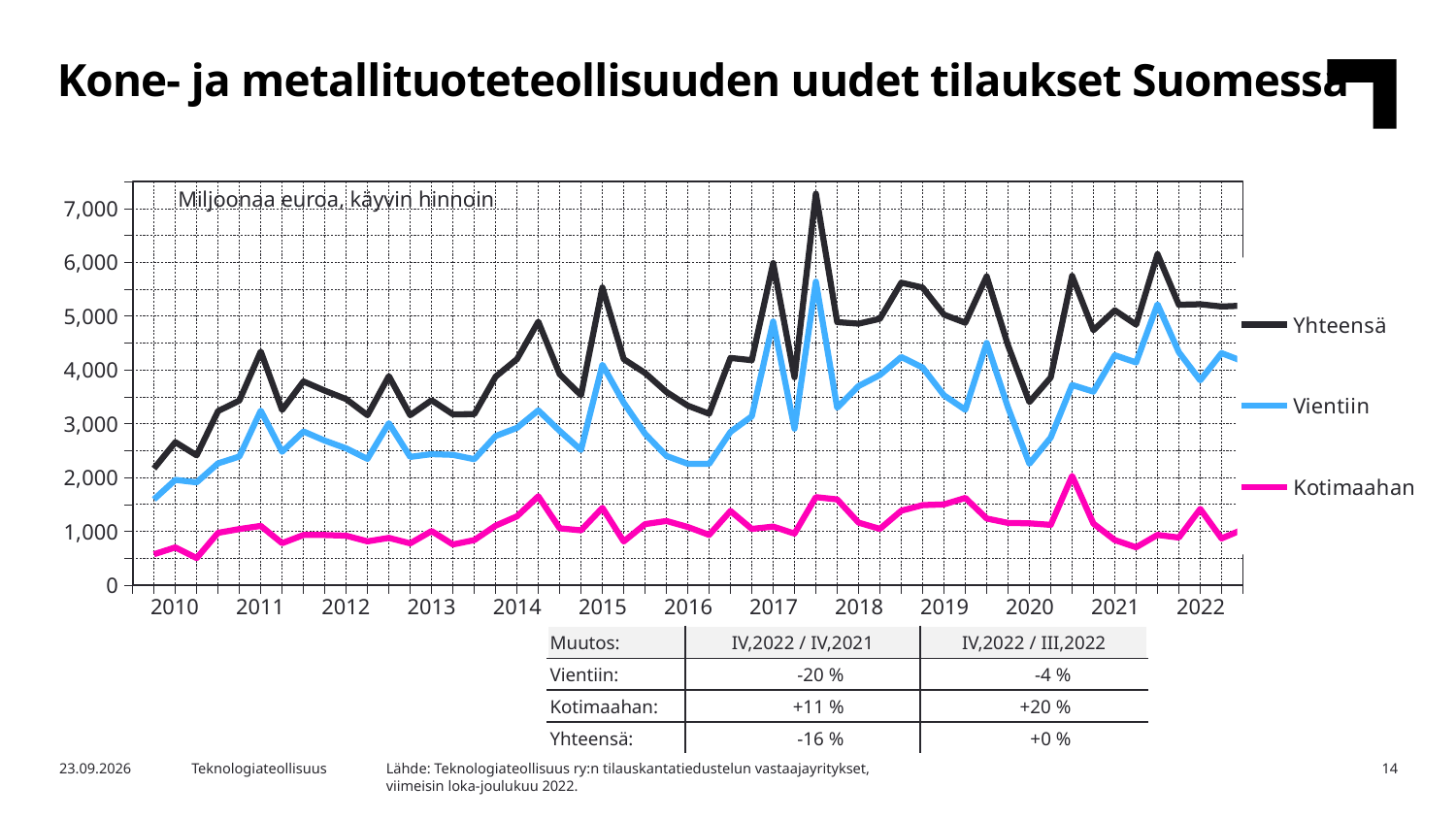
Which is larger in 2022, Vientiin or Kotimaahan? Vientiin Which series has the lowest values throughout the chart? Kotimaahan What is the title of the slide's chart? Kone- ja metallituoteteollisuuden uudet tilaukset Suomessa Is the peak value of Yhteensä in 2017 greater or less than 7,000? greater How many years are labelled on the x axis? 13 How many series does the legend list? 3 Which series is shown with the black line? Yhteensä Is the value for Kotimaahan at the start of 2010 greater or less than 1,000? less According to the table, what is the change for Vientiin from IV,2021 to IV,2022? -20 % Is the value for Vientiin at its 2020 low point greater or less than 3,000? less Which series has the highest values throughout the chart? Yhteensä What kind of chart is shown on the slide? Line chart